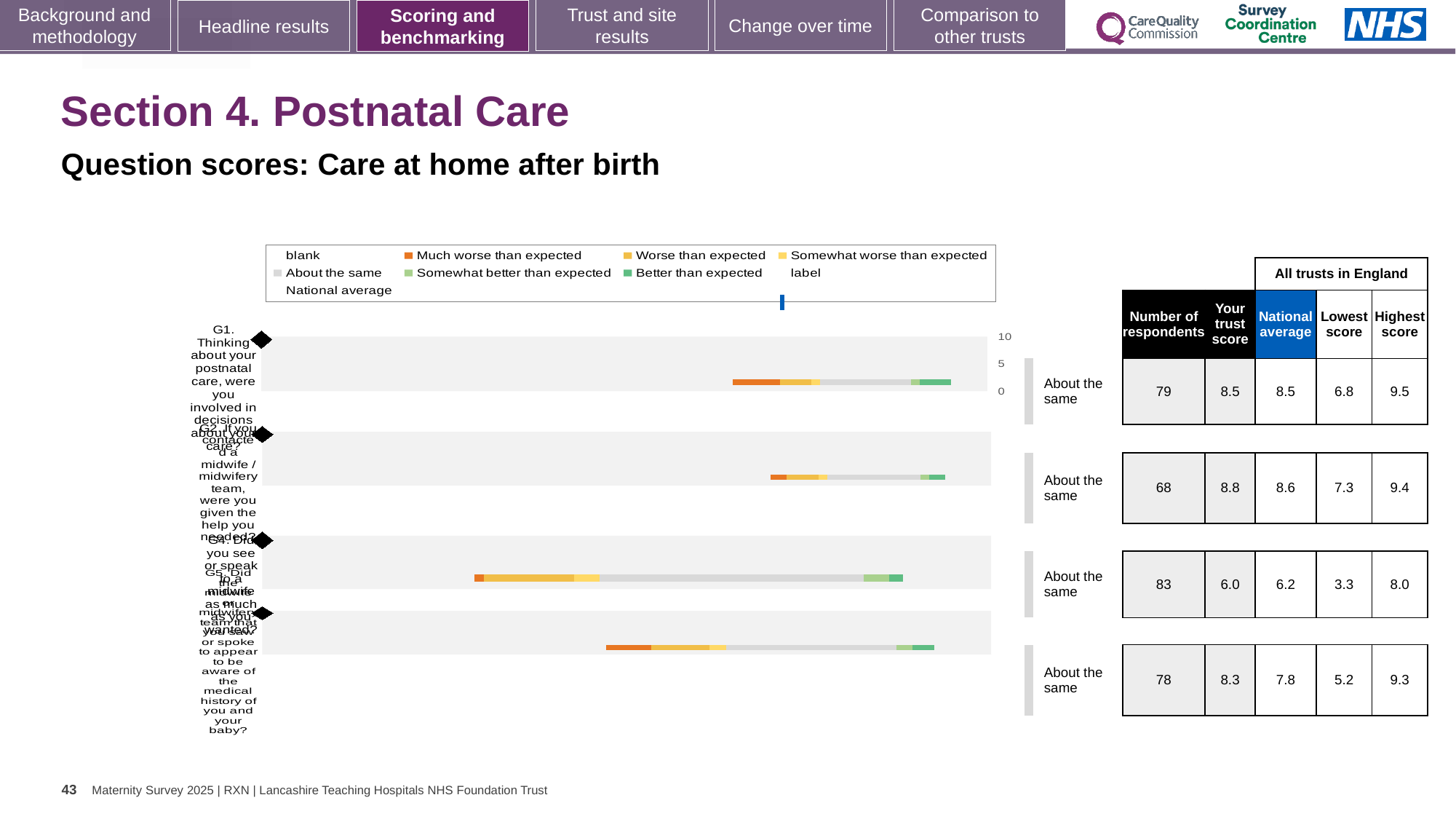
How many question rows (bars) are plotted in the chart? 4 What is the trust score for the second question row (G2)? 8.8 What is the national average for the third question row? 6.2 What kind of chart is shown on the slide? bar chart What is the number of respondents for the first question row (G1)? 79 What is the subtitle describing the question scores on this slide? Question scores: Care at home after birth What is the highest score among all trusts in England for the first question row (G1)? 9.5 Which question row has the lowest trust score? the third row, 6.0 For the fourth question row, what is the difference between the trust score and the national average? 0.5 What is the lowest score among all trusts in England for the fourth question row? 5.2 What benchmark category is shown next to every bar in the chart? About the same Which question row has the highest trust score? the second row (G2), 8.8